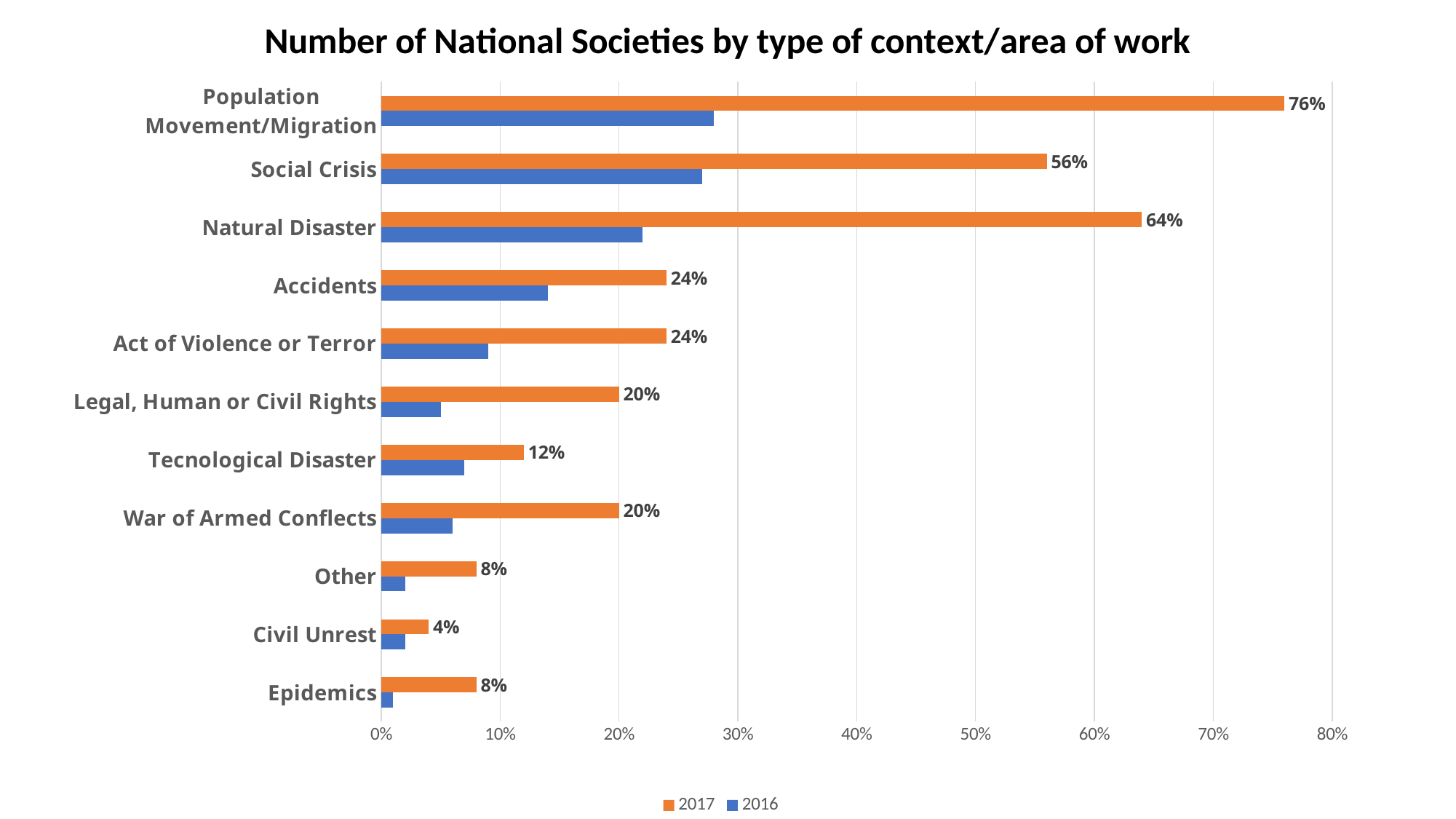
Which is larger in 2017: Accidents or Tecnological Disaster? Accidents What is the 2017 value for Civil Unrest? 4% What type of chart is shown? Bar chart What is the 2017 value for Natural Disaster? 64% Is the 2016 value for Legal, Human or Civil Rights greater or less than 10%? less What is the 2017 value for Population Movement/Migration? 76% How many series does the legend list? 2 How many categories are shown on the chart? 11 Which category has the lowest 2017 value? Civil Unrest What is the difference between the 2017 values for Natural Disaster and Social Crisis? 8% Which category has the highest 2017 value? Population Movement/Migration Is the 2016 value for Population Movement/Migration greater or less than 20%? greater